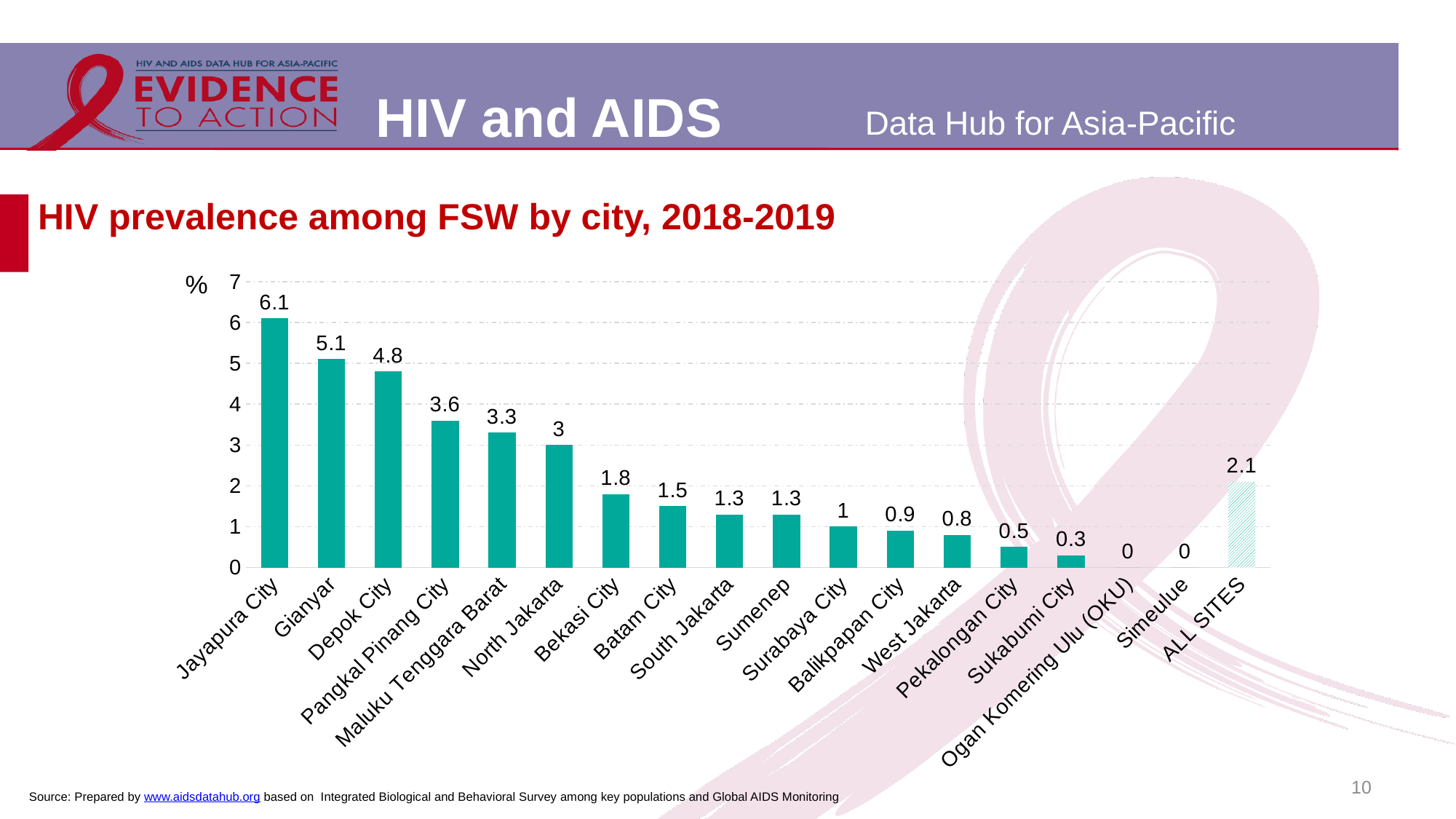
What is the title of the chart? HIV prevalence among FSW by city, 2018-2019 What is the HIV prevalence among FSW in Jayapura City? 6.1 Which city has the highest HIV prevalence among FSW? Jayapura City What is the HIV prevalence among FSW in Pangkal Pinang City? 3.6 What is the value shown for ALL SITES? 2.1 Which cities show a value of 0? Ogan Komering Ulu (OKU) and Simeulue Do the values rise or fall from Jayapura City to Simeulue along the x axis? Fall How many categories are shown on the x axis, including ALL SITES? 18 What kind of chart is shown on the slide? Bar chart Which has a higher HIV prevalence, Bekasi City or Batam City? Bekasi City Is the value for North Jakarta greater or less than 2? greater What is the difference between the values for Gianyar and Depok City? 0.3